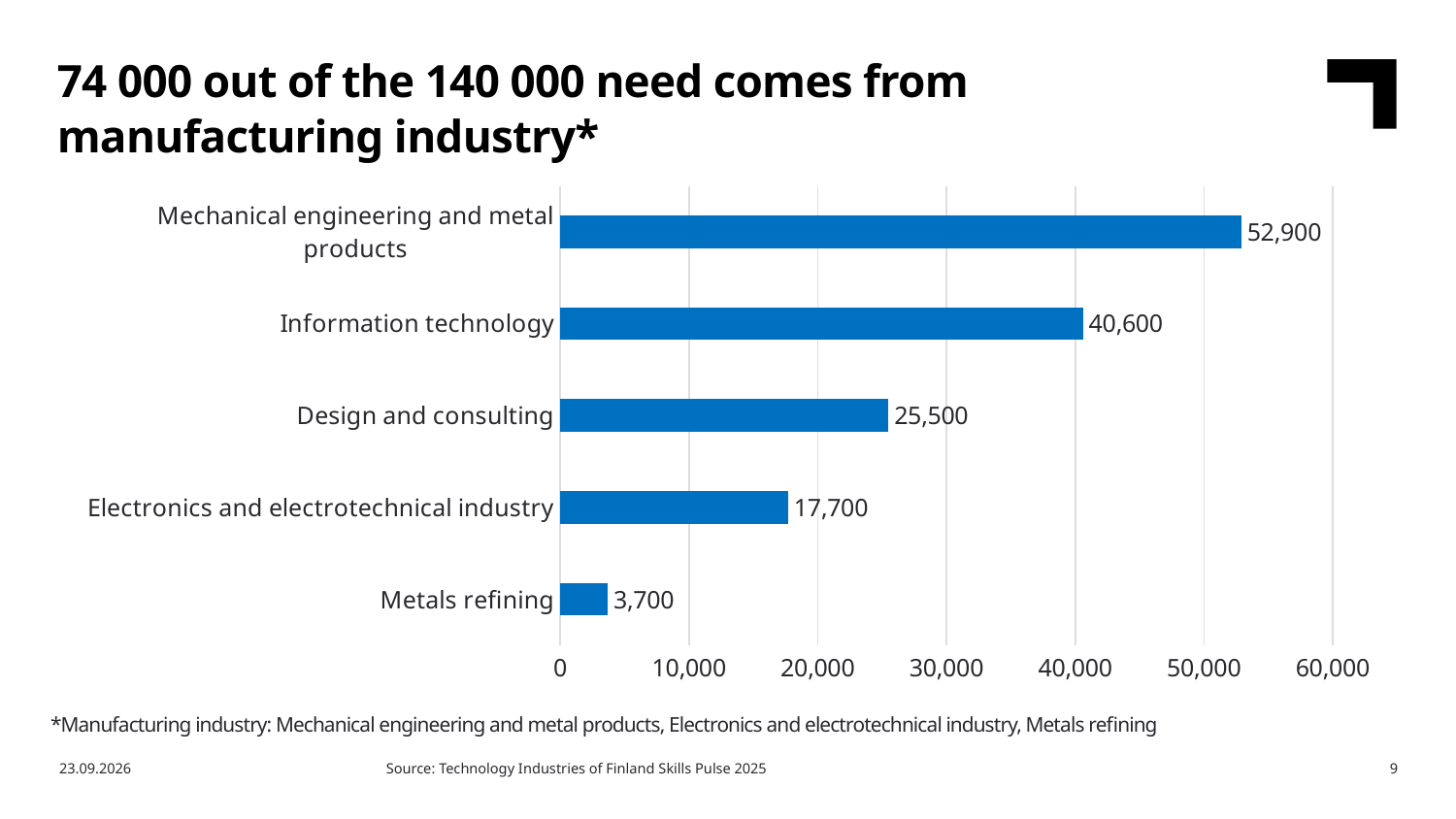
What is the value for Information technology? 40,600 What is the value for Electronics and electrotechnical industry? 17,700 Which category has the lowest value? Metals refining What is the highest value shown on the x axis? 60,000 Which is larger, Design and consulting or Electronics and electrotechnical industry? Design and consulting What is the difference between Design and consulting and Electronics and electrotechnical industry? 7,800 Which category has the highest value? Mechanical engineering and metal products What kind of chart is shown on the slide? Bar chart What is the difference between Mechanical engineering and metal products and Information technology? 12,300 How many categories are shown in the chart? 5 Is the value for Information technology greater or less than 30,000? greater What is the value for Metals refining? 3,700